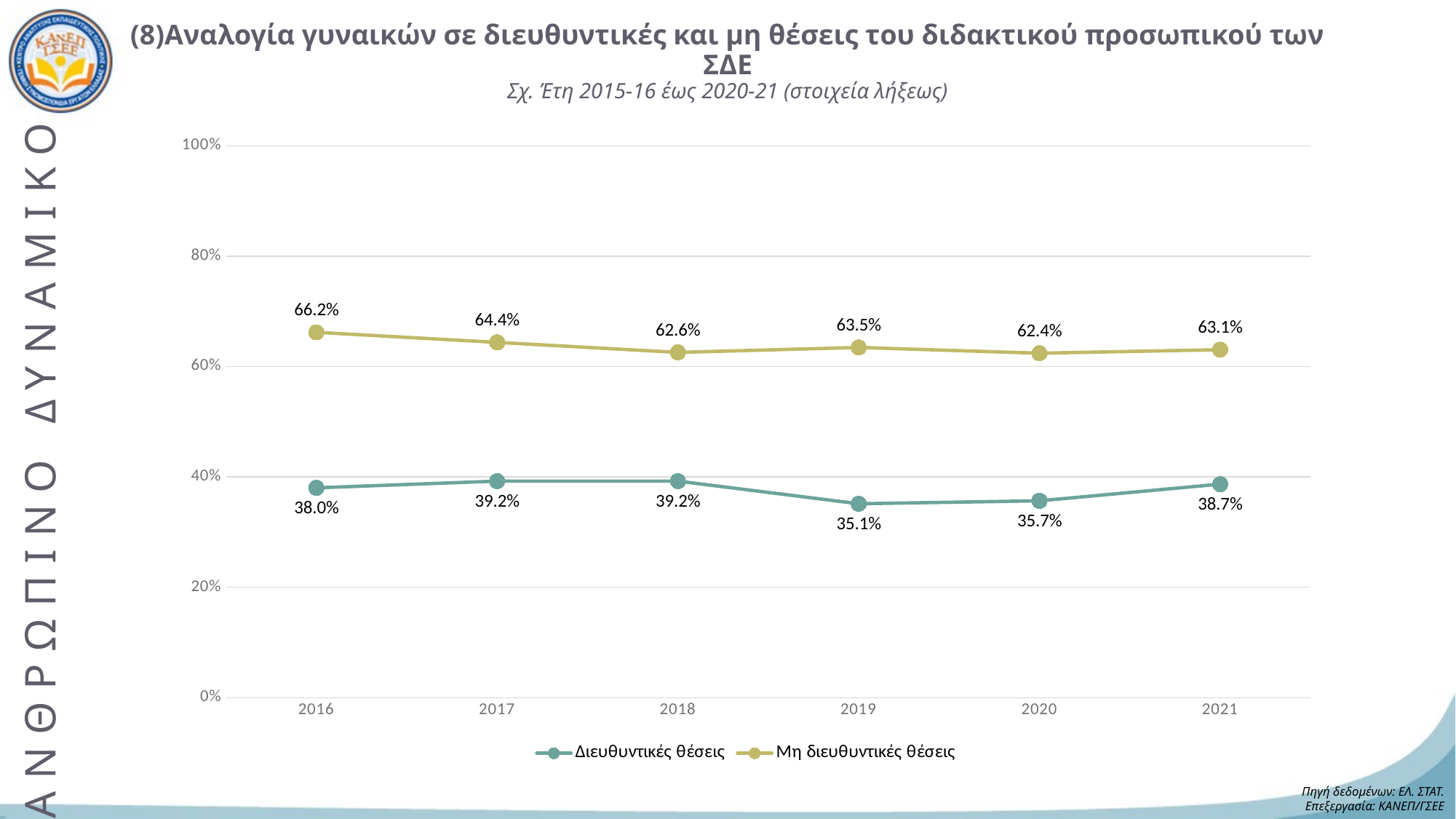
What kind of chart is shown on the slide? line chart What is the value for Διευθυντικές θέσεις in 2019? 35.1% What is the value for Μη διευθυντικές θέσεις in 2021? 63.1% In which year is the value for Μη διευθυντικές θέσεις highest? 2016 In which year is the value for Διευθυντικές θέσεις lowest? 2019 How many series does the legend list? 2 Is the value for Μη διευθυντικές θέσεις in 2018 greater or less than 60%? greater Which is larger for Διευθυντικές θέσεις: the value in 2020 or the value in 2021? 2021 Does the value for Μη διευθυντικές θέσεις rise or fall from 2016 to 2018? fall How many years are shown on the x axis? 6 What is the value for Μη διευθυντικές θέσεις in 2016? 66.2% What is the difference between the Μη διευθυντικές θέσεις and Διευθυντικές θέσεις values in 2016? 28.2%